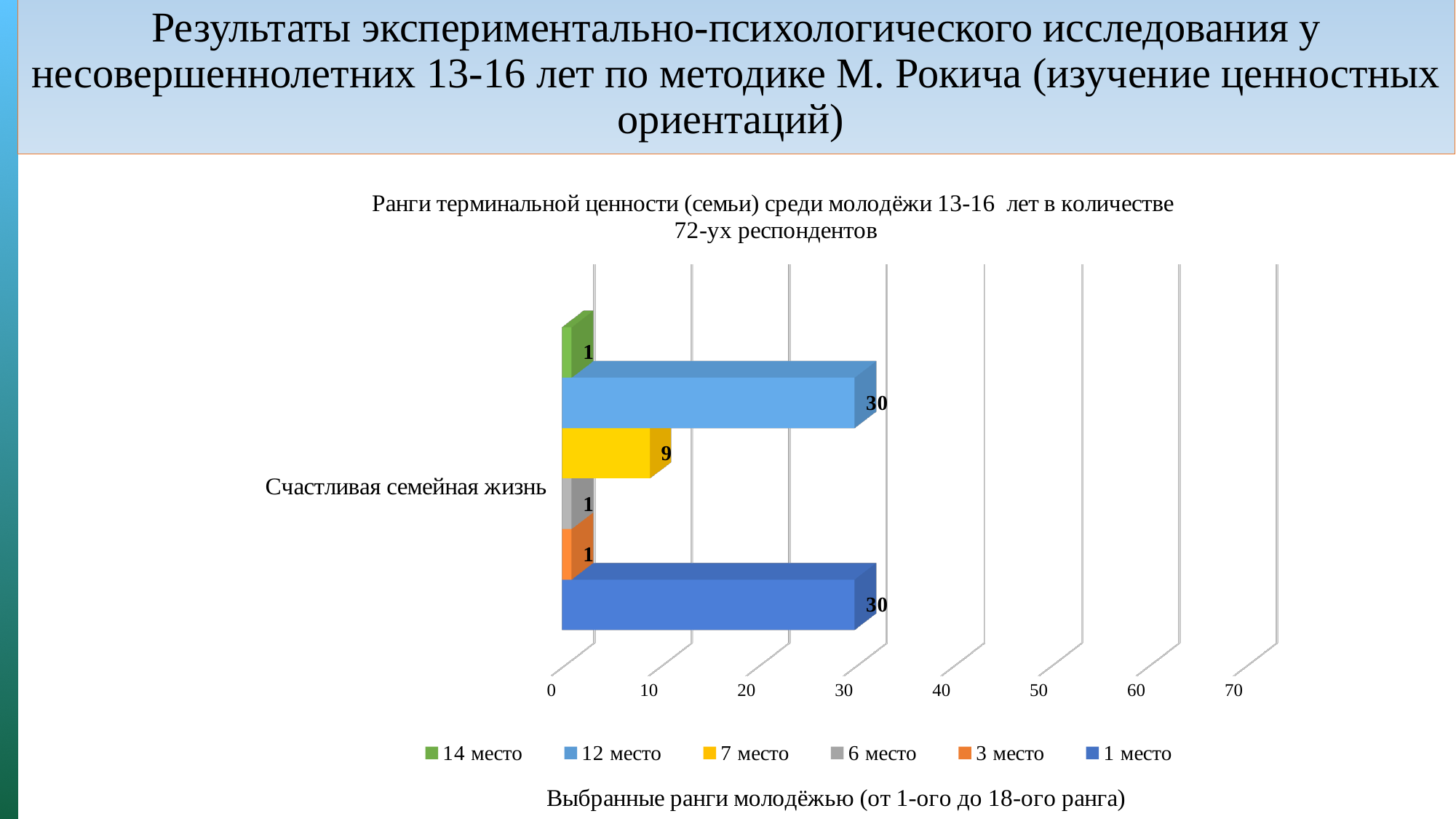
How many categories are shown on the vertical axis of the chart? 1 Is the value for "1 место" greater or less than 20? greater What value is shown for the series "1 место"? 30 What is the difference between the values for "12 место" and "7 место"? 21 Which is larger, the value for "7 место" or the value for "6 место"? 7 место What kind of chart is shown on the slide? bar chart What is the label of the single category shown on the chart? Счастливая семейная жизнь How many series does the legend list? 6 What value is shown for the series "7 место"? 9 What value is shown for the series "12 место"? 30 What value is shown for the series "3 место"? 1 What value is shown for the series "14 место"? 1